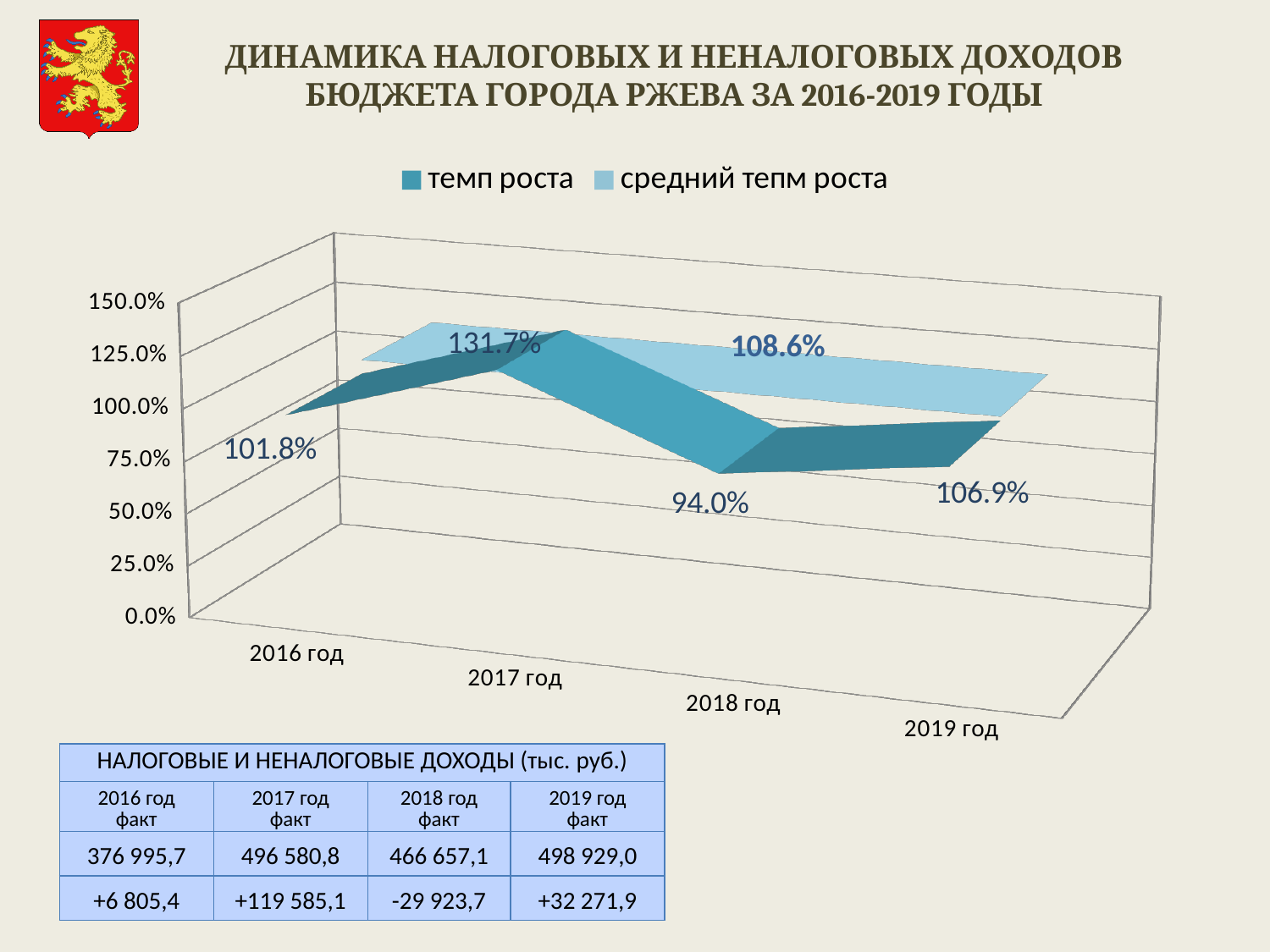
How many years are shown on the x axis of the chart? 4 What is the value of темп роста for 2019 год? 106.9% Which is larger, темп роста for 2016 год or for 2019 год? 2019 год In which year is темп роста the lowest? 2018 год In which year is темп роста the highest? 2017 год What is the value of темп роста for 2016 год? 101.8% What kind of chart is shown on the slide? 3D line chart What is the value of темп роста for 2017 год? 131.7% How many series does the legend list? 2 What value is labelled on the средний тепм роста series? 108.6% What is the value of темп роста for 2018 год? 94.0% What is the difference between темп роста in 2017 год and 2018 год? 37.7%